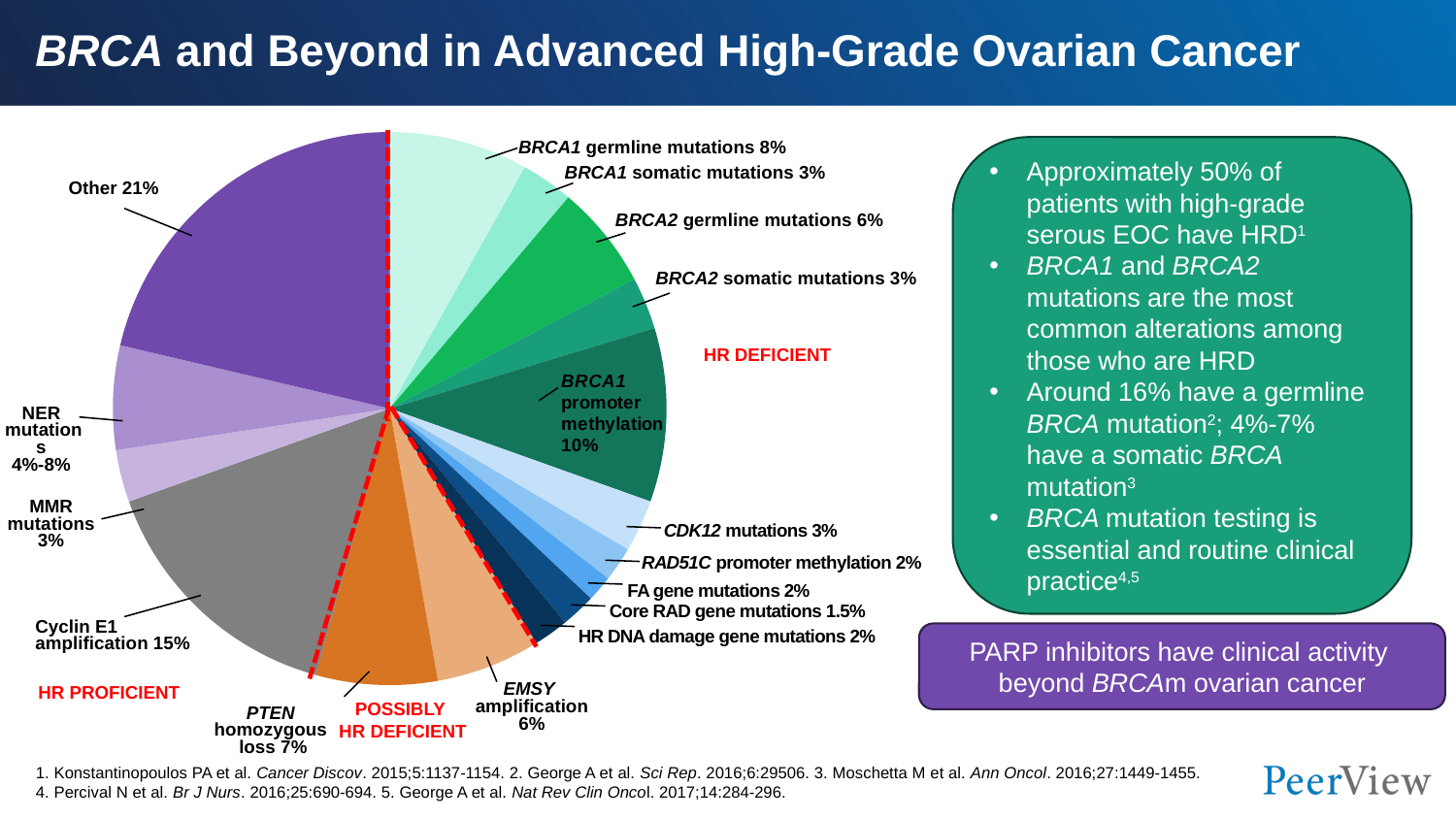
What is the difference in percentage points between Cyclin E1 amplification and BRCA1 promoter methylation? 5 percentage points What kind of chart is shown on the slide? Pie chart Which is larger: BRCA1 germline mutations or BRCA2 germline mutations? BRCA1 germline mutations How many labeled slices does the pie chart have? 16 Which slice of the pie chart is the largest? Other 21% Which labeled slice of the pie chart has the smallest percentage? Core RAD gene mutations 1.5% What range is given for NER mutations? 4%-8% What percentage is shown for BRCA1 promoter methylation? 10% What percentage is shown for Cyclin E1 amplification? 15% Which group label in red is placed next to the PTEN homozygous loss and EMSY amplification slices? POSSIBLY HR DEFICIENT What percentage is shown for Core RAD gene mutations? 1.5% What percentage of the pie is labeled as BRCA1 germline mutations? 8%